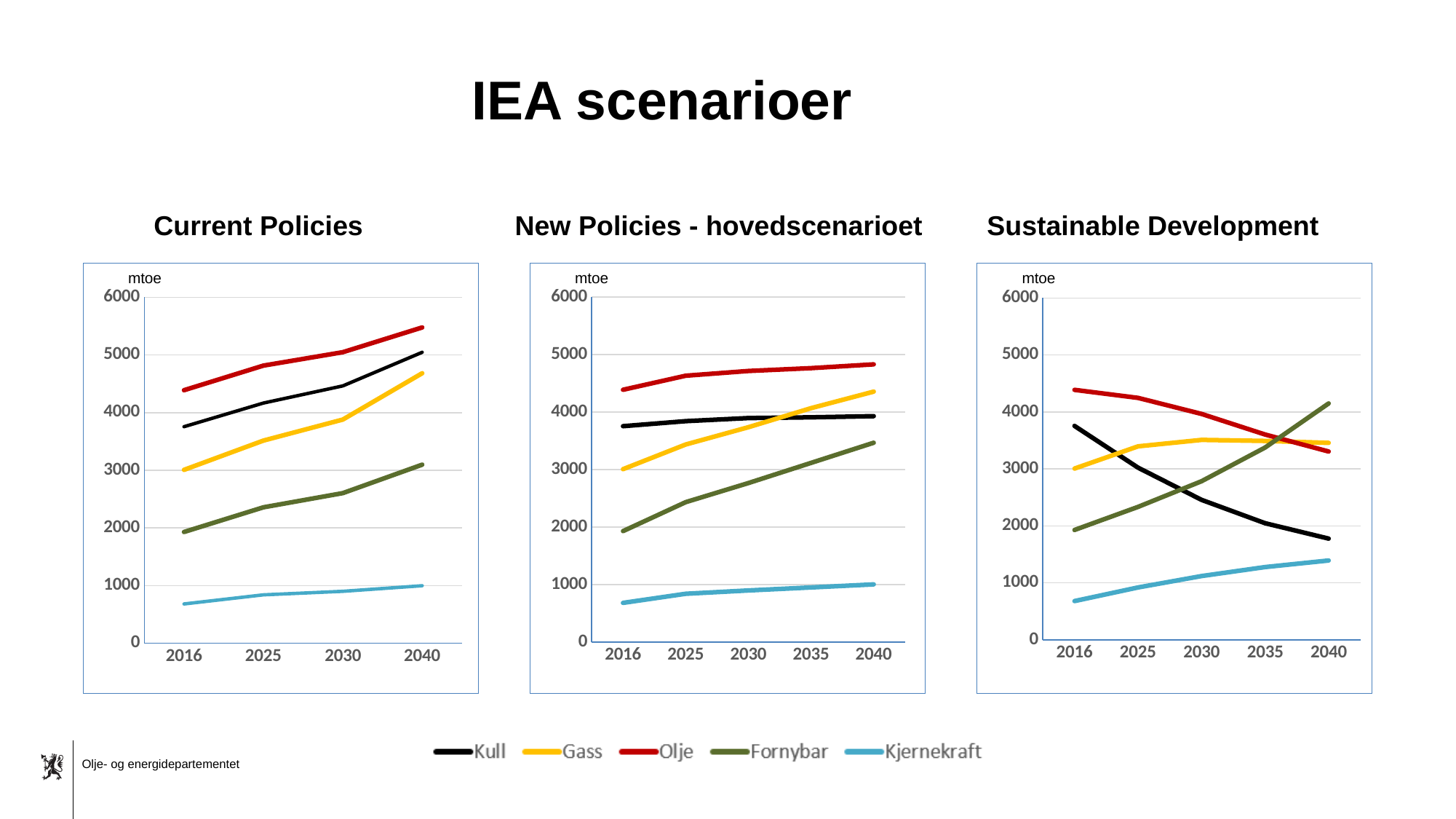
How many years are shown on the x axis of the "Current Policies" chart? 4 In the "New Policies - hovedscenarioet" chart, which is larger in 2040, Gass or Kull? Gass In the "Sustainable Development" chart, is the value for Kull in 2040 greater or less than 2000? less In the "Current Policies" chart, does the Olje line rise or fall from 2016 to 2040? rise What kind of chart is the "Current Policies" chart? line chart How many years are shown on the x axis of the "Sustainable Development" chart? 5 In the "New Policies - hovedscenarioet" chart, which series has the lowest value in 2040? Kjernekraft How many series does the legend list for the charts? 5 In the "Sustainable Development" chart, does the Kull line rise or fall from 2016 to 2040? fall In the "Current Policies" chart, which series has the highest value in 2040? Olje In the "Current Policies" chart, is the value for Olje in 2040 greater or less than 5000? greater In the "Sustainable Development" chart, which series has the highest value in 2040? Fornybar